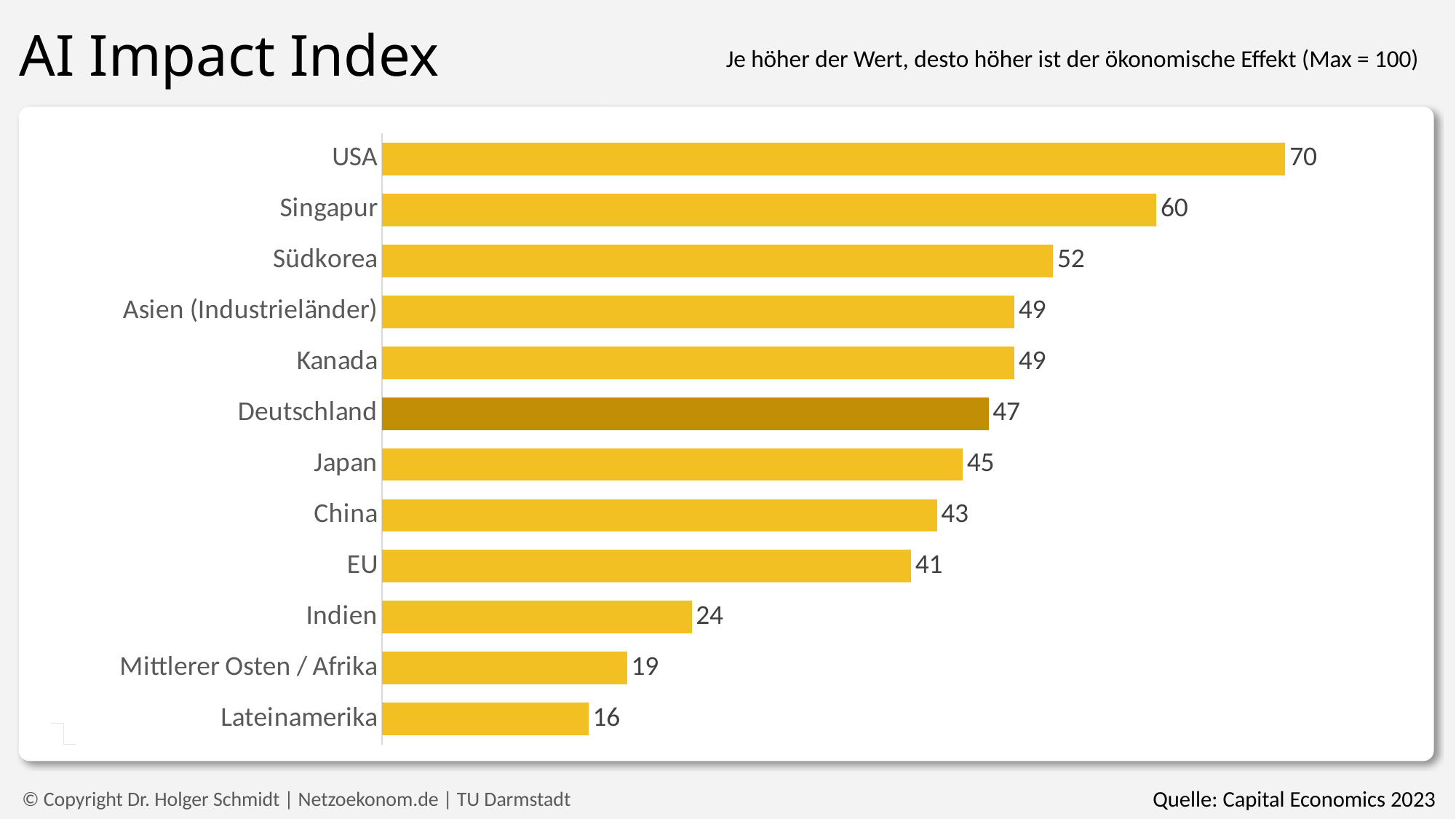
What is the difference between the values for Südkorea and China? 9 Which category has the highest AI Impact Index value? USA Which has a higher value, Japan or EU? Japan Which category has the lowest AI Impact Index value? Lateinamerika What is the AI Impact Index value for Singapur? 60 How many categories are shown in the chart? 12 Which bar is highlighted in a darker colour than the others? Deutschland What is the AI Impact Index value for Deutschland? 47 What is the difference between the values for USA and Deutschland? 23 Which has a higher value, Mittlerer Osten / Afrika or Indien? Indien What kind of chart is shown on the slide? Bar chart What is the value shown for Indien? 24